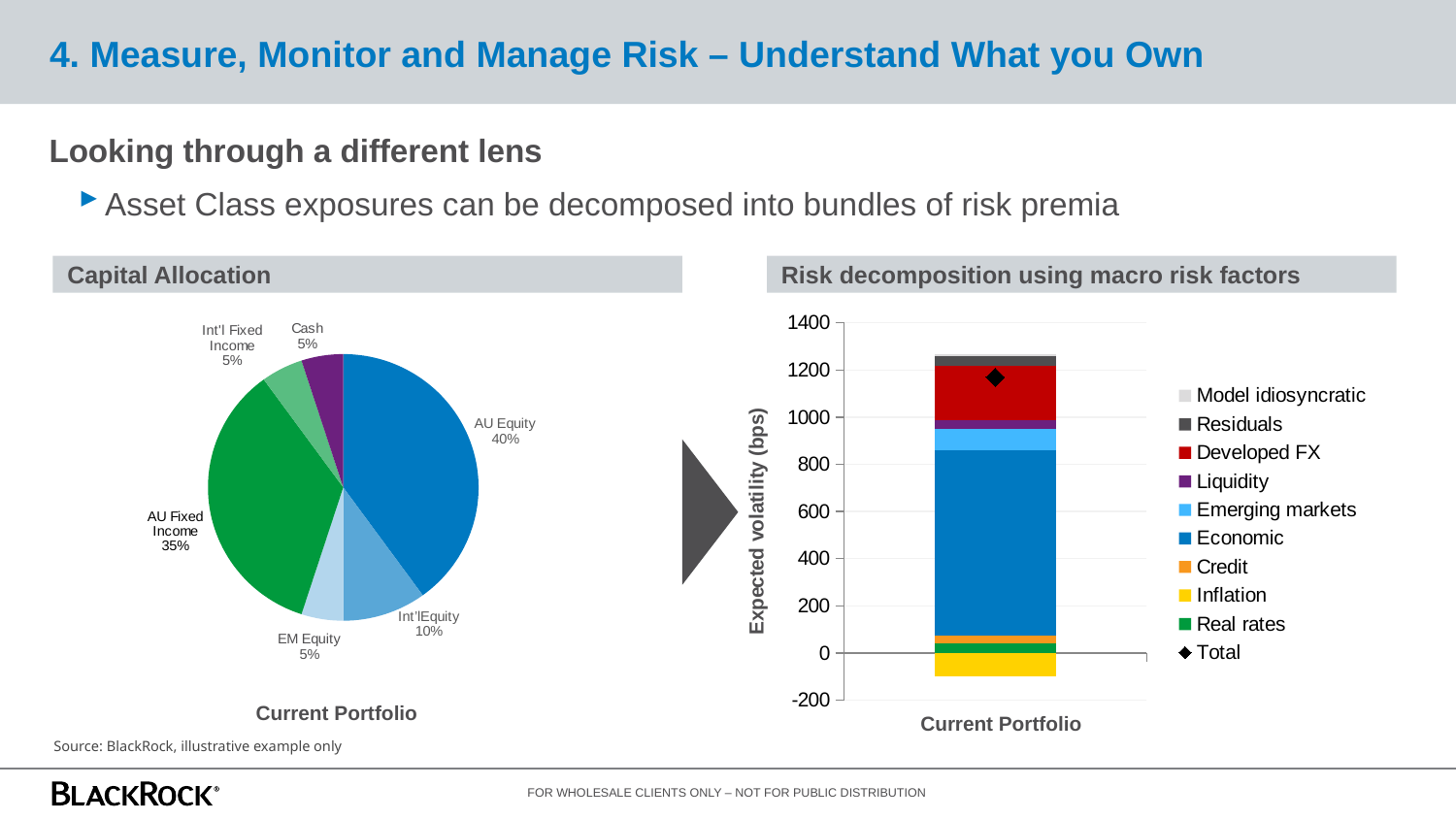
On the Capital Allocation pie chart, what share of the portfolio is AU Equity? 40% What kind of chart is shown under the Risk decomposition using macro risk factors heading? Stacked bar chart On the Capital Allocation pie chart, what is the difference in percentage points between AU Equity and AU Fixed Income? 5% On the Capital Allocation pie chart, which is larger, EM Equity or Int'l Equity? Int'l Equity What kind of chart is shown under the Capital Allocation heading? Pie chart On the Risk decomposition chart, what is the y-axis label? Expected volatility (bps) On the Risk decomposition chart, how many entries does the legend list? 10 On the Risk decomposition chart, is the Total marker for Current Portfolio greater or less than 1000? greater On the Capital Allocation pie chart, what share of the portfolio is AU Fixed Income? 35% On the Capital Allocation pie chart, which asset class has the largest share? AU Equity On the Capital Allocation pie chart, how many slices are there? 6 On the Capital Allocation pie chart, what share of the portfolio is Int'l Equity? 10%